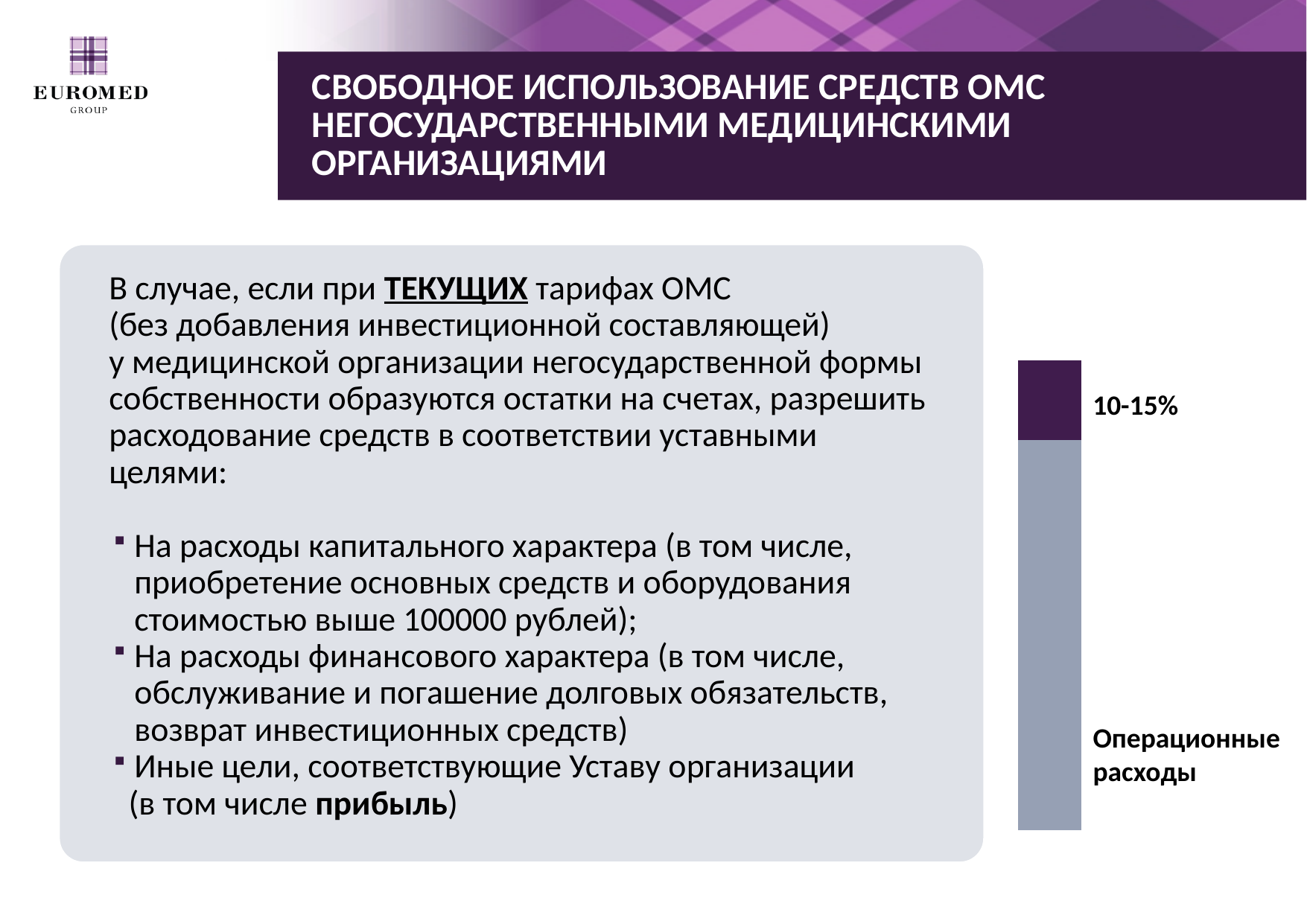
What label is printed next to the bottom (grey) segment of the bar? Операционные расходы What label is printed next to the top (dark purple) segment of the bar? 10-15% Which segment of the bar is larger: the one labelled 10-15% or the one labelled Операционные расходы? Операционные расходы Which segment takes up the largest part of the stacked bar? Операционные расходы What kind of chart is shown on the right side of the slide? bar chart How many segments does the stacked bar on the right of the slide have? 2 Which segment takes up the smallest part of the stacked bar? 10-15% What colour is the segment labelled Операционные расходы? grey What colour is the segment labelled 10-15%? dark purple